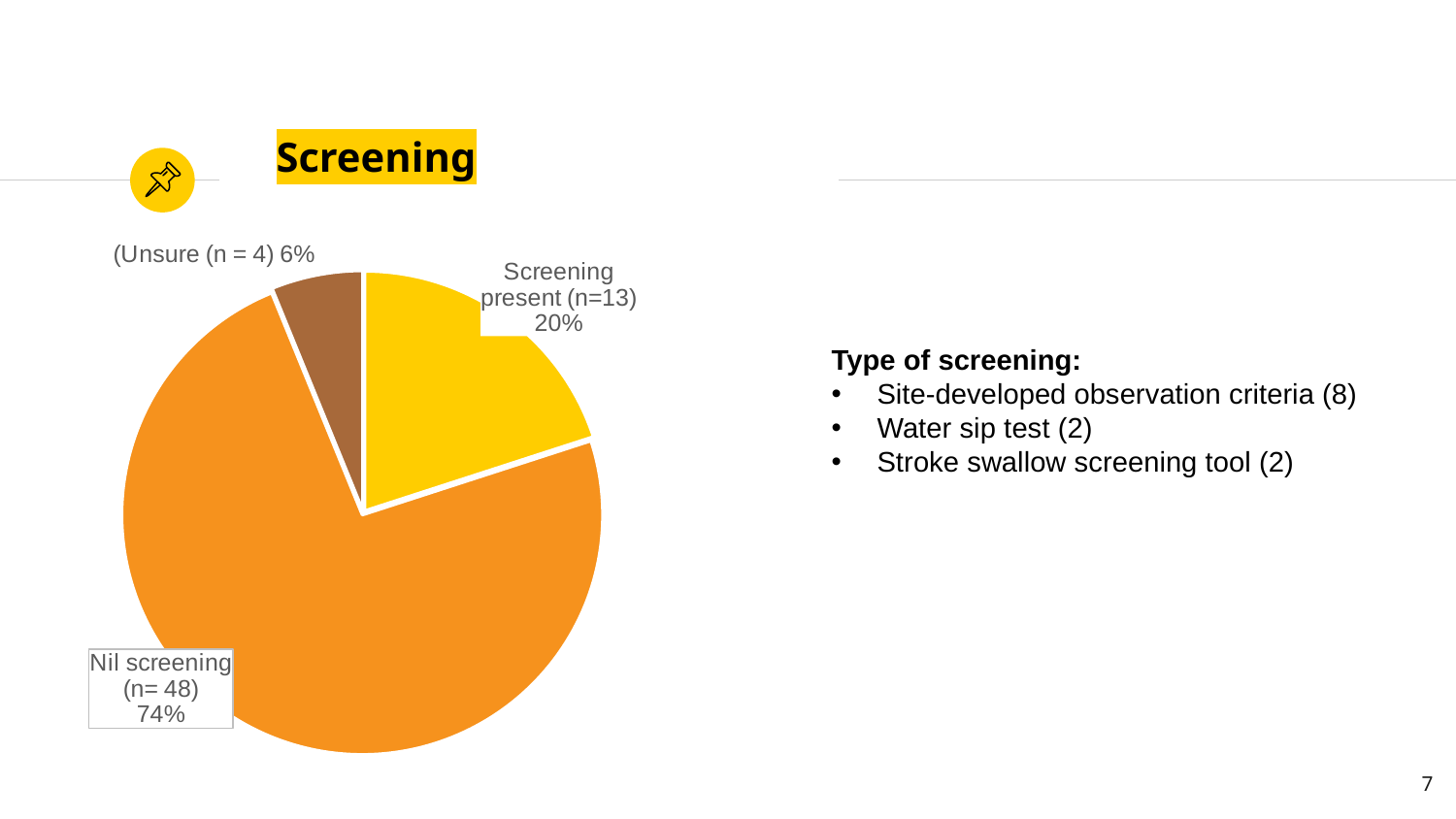
How many slices does the pie chart have? 3 What percentage of the pie is the Unsure slice? 6% Which slice of the pie chart is the smallest? Unsure Which slice of the pie chart is the largest? Nil screening What is the n value for the Nil screening slice? 48 Which slice is larger, Screening present or Unsure? Screening present What is the difference in percentage points between the Nil screening slice and the Screening present slice? 54 What percentage of the pie is the Screening present slice? 20% What kind of chart is shown on the slide? Pie chart What percentage of the pie is the Nil screening slice? 74% What is the n value for the Screening present slice? 13 What is the n value for the Unsure slice? 4